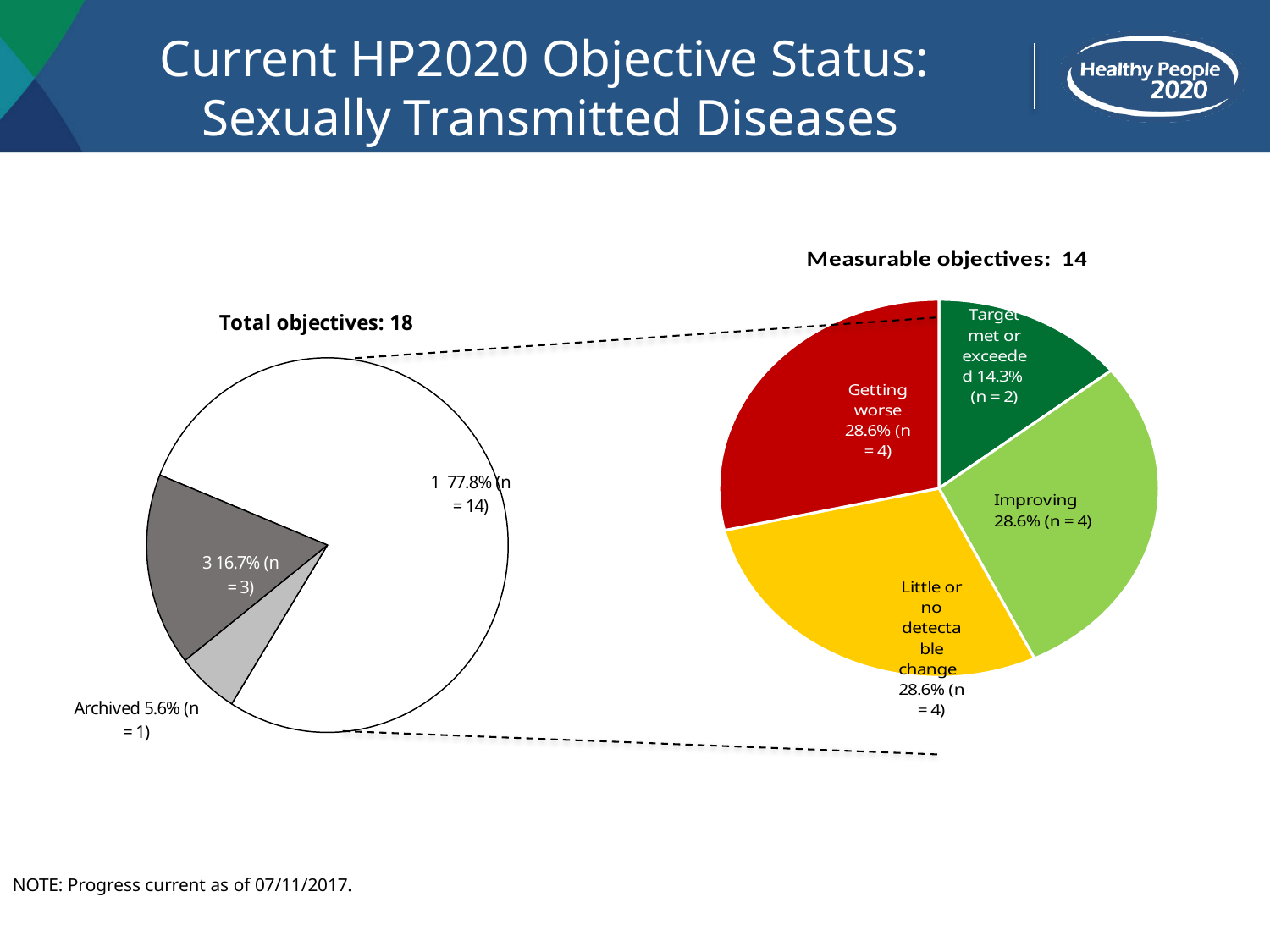
In the 'Measurable objectives: 14' pie chart, what percentage of objectives are 'Target met or exceeded'? 14.3% In the 'Measurable objectives: 14' pie chart, how many categories are shown? 4 In the 'Total objectives: 18' pie chart, what share does the largest slice represent? 77.8% In the 'Measurable objectives: 14' pie chart, what is the difference in percentage points between 'Improving' and 'Target met or exceeded'? 14.3 In the 'Measurable objectives: 14' pie chart, what percentage of objectives are 'Improving'? 28.6% What type of charts are shown on the slide? Pie charts In the 'Measurable objectives: 14' pie chart, which is larger: 'Little or no detectable change' or 'Target met or exceeded'? Little or no detectable change In the 'Total objectives: 18' pie chart, how many objectives are 'Archived'? 1 In the 'Measurable objectives: 14' pie chart, which category has the smallest share? Target met or exceeded In the 'Measurable objectives: 14' pie chart, what colour is the 'Getting worse' slice? Red In the 'Total objectives: 18' pie chart, what percentage of objectives are 'Archived'? 5.6% In the 'Measurable objectives: 14' pie chart, how many objectives are 'Getting worse'? 4